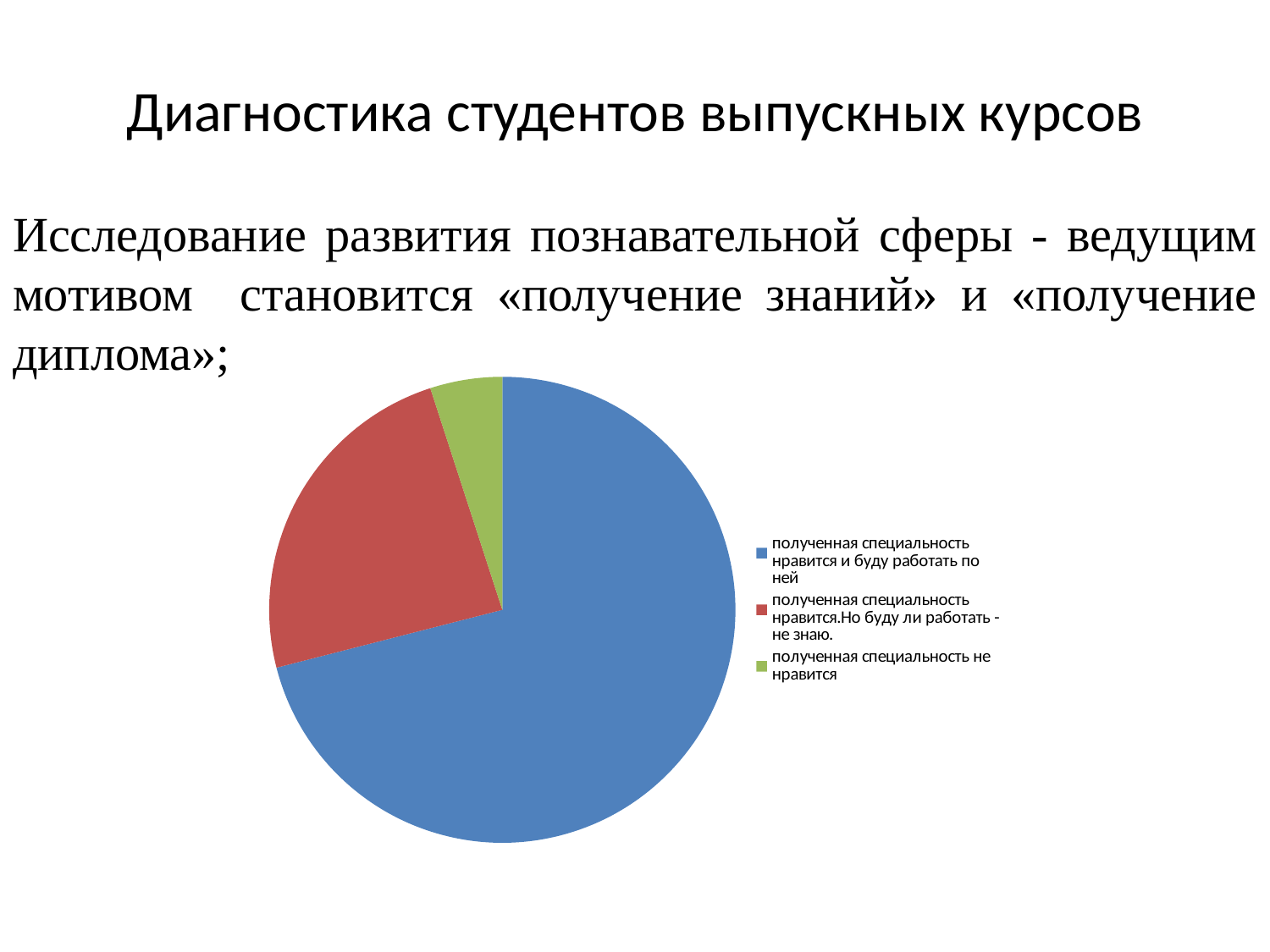
Which category has the smallest slice of the pie chart? полученная специальность не нравится Which slice is larger: "полученная специальность нравится.Но буду ли работать - не знаю." or "полученная специальность не нравится"? полученная специальность нравится.Но буду ли работать - не знаю. How many entries does the legend of the pie chart list? 3 What colour is the slice for "полученная специальность не нравится"? green Which category is shown in red in the pie chart? полученная специальность нравится.Но буду ли работать - не знаю. Does the largest slice of the pie chart take up more or less than half of the pie? more How many slices does the pie chart have? 3 What kind of chart is shown on the slide? pie chart Which slice is larger: "полученная специальность нравится и буду работать по ней" or "полученная специальность нравится.Но буду ли работать - не знаю."? полученная специальность нравится и буду работать по ней Which category has the largest slice of the pie chart? полученная специальность нравится и буду работать по ней